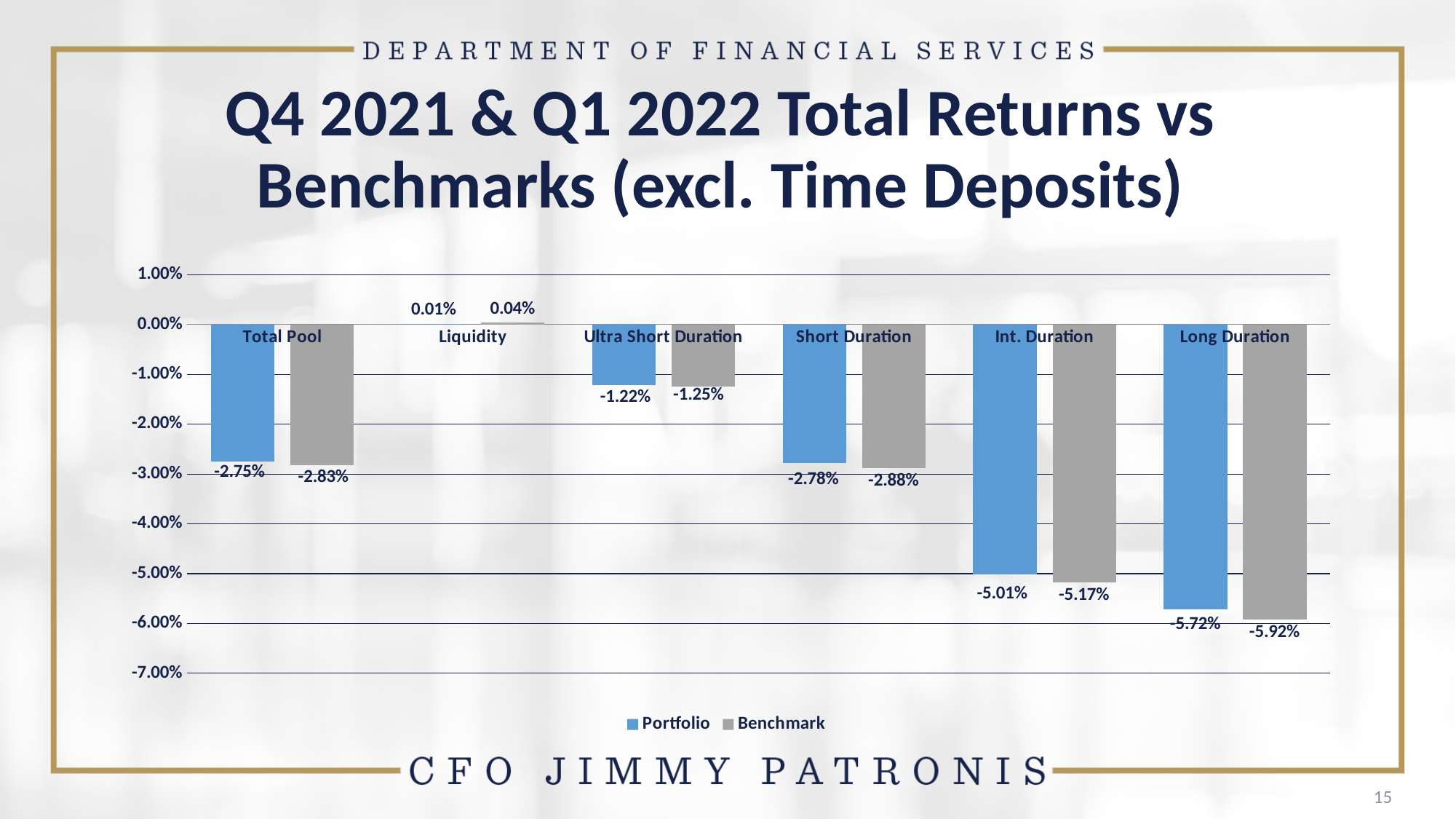
What is the difference between the Portfolio and Benchmark values for Short Duration? 0.10% What is the Portfolio value for Liquidity? 0.01% Which is larger, the Portfolio value for Ultra Short Duration or the Portfolio value for Short Duration? Ultra Short Duration What is the Benchmark value for Long Duration? -5.92% What is the Benchmark value for Int. Duration? -5.17% Which category has the lowest Portfolio value? Long Duration How many series does the legend list? 2 Which colour represents the Benchmark series? Gray Which category has the highest Benchmark value? Liquidity What kind of chart is shown on the slide? Bar chart What is the Portfolio value for Total Pool? -2.75% How many categories are shown on the x axis? 6